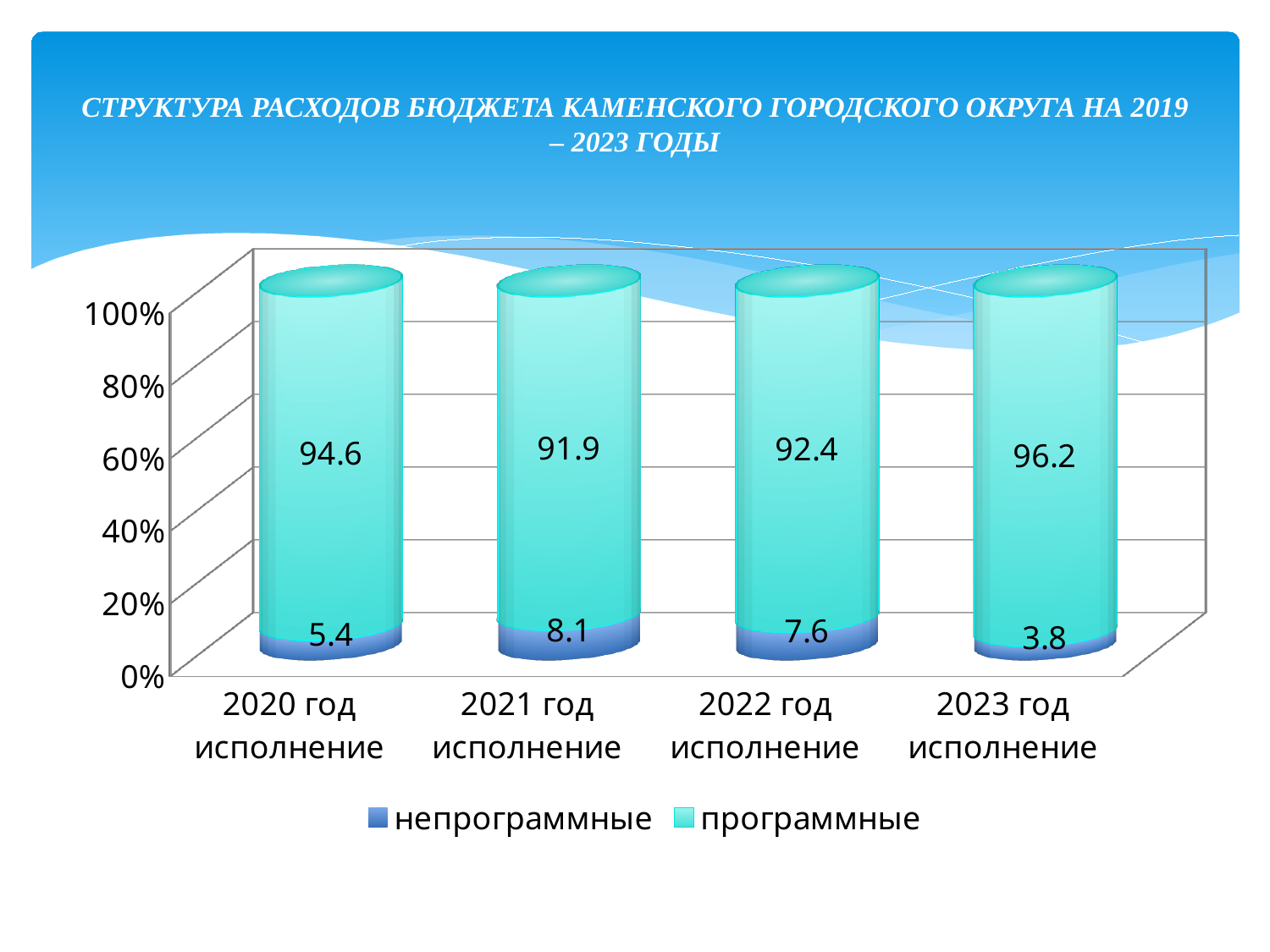
Which legend entry is shown in blue? непрограммные How many categories are shown on the x axis? 4 Which is larger: непрограммные in 2020 год исполнение or in 2023 год исполнение? 2020 год исполнение What is the value for непрограммные in 2021 год исполнение? 8.1 How many series does the legend list? 2 What is the difference between the программные values for 2023 год исполнение and 2020 год исполнение? 1.6 What kind of chart is shown on the slide? Stacked bar chart Which year has the highest value for непрограммные? 2021 год исполнение Which year has the lowest value for программные? 2021 год исполнение What is the value for программные in 2020 год исполнение? 94.6 What is the value for программные in 2023 год исполнение? 96.2 What is the value for непрограммные in 2022 год исполнение? 7.6